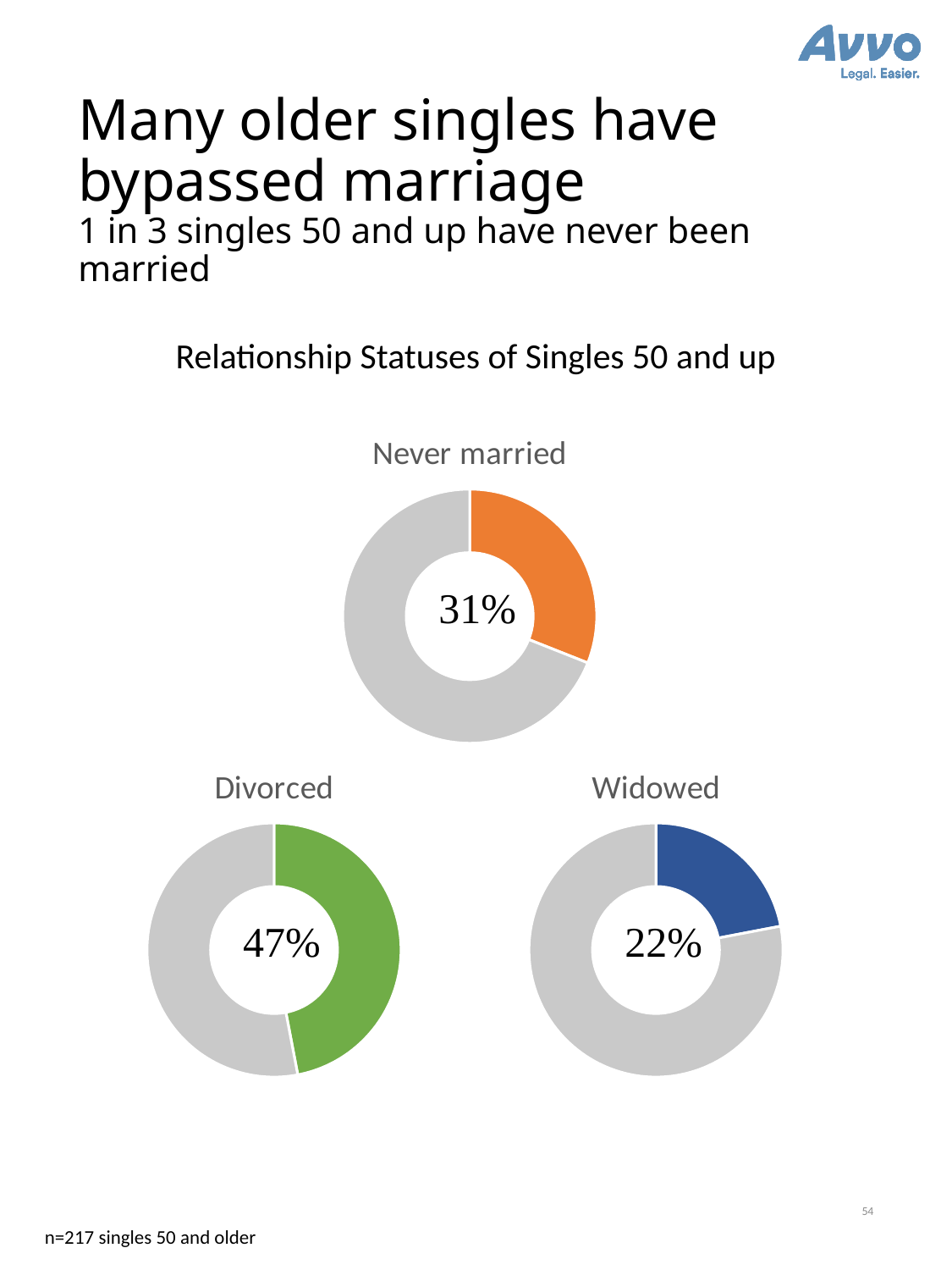
Across the three charts, which relationship status has the highest percentage? Divorced In the 'Never married' chart, what percentage is shown? 31% In the 'Divorced' chart, what percentage is shown? 47% Which is larger, the 'Never married' percentage or the 'Widowed' percentage? Never married What colour is the highlighted segment in the 'Widowed' chart? Blue What is the difference between the 'Never married' percentage and the 'Widowed' percentage? 9% In the 'Widowed' chart, what percentage is shown? 22% How many donut charts are shown on the slide? 3 What is the difference between the 'Divorced' percentage and the 'Never married' percentage? 16% Across the three charts, which relationship status has the lowest percentage? Widowed What kind of chart is used for the 'Divorced' figure? Donut (pie) chart What is the overall title above the three charts? Relationship Statuses of Singles 50 and up